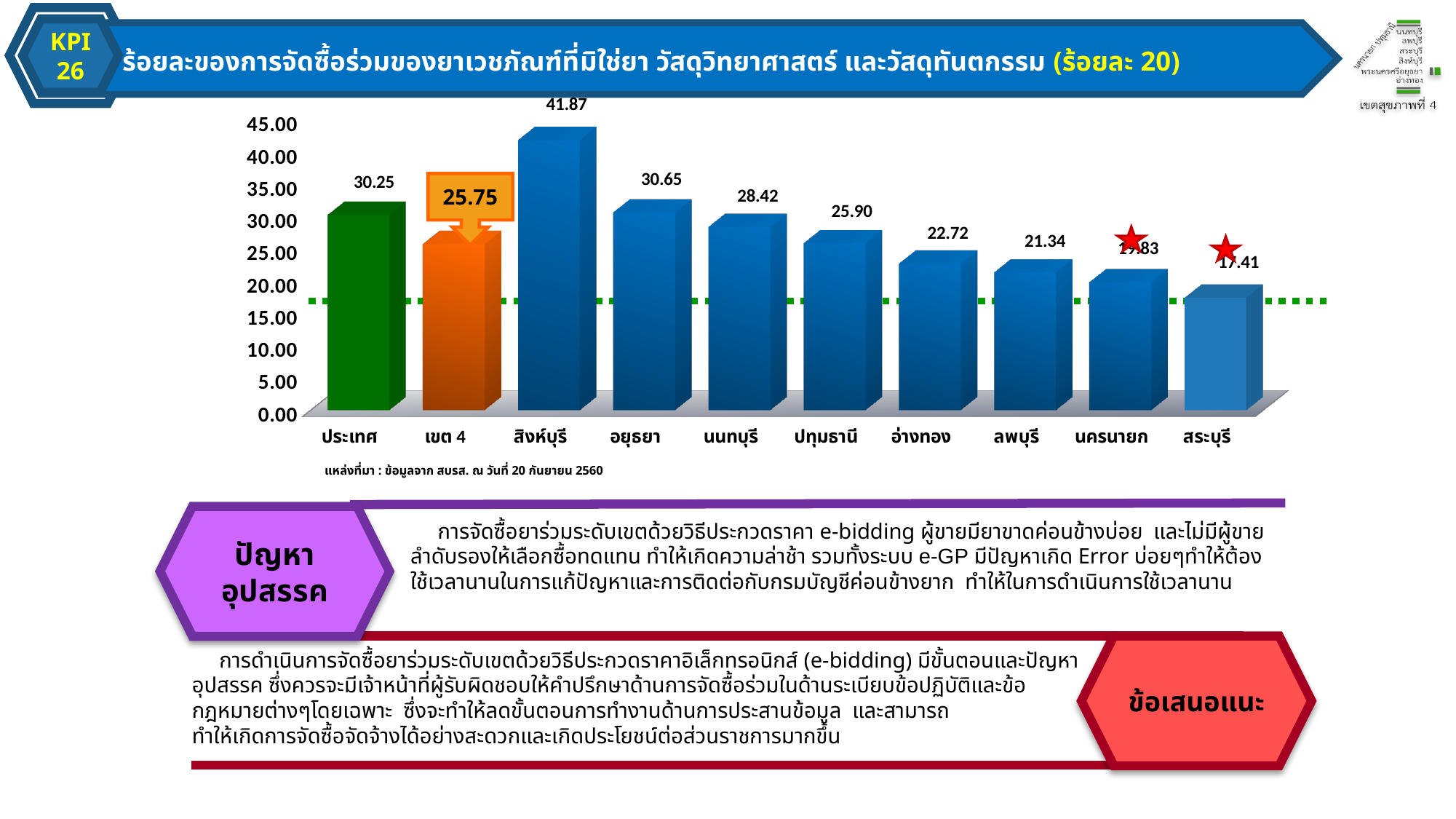
What is the value for สิงห์บุรี? 41.87 What is the value for เขต 4? 25.75 Is the value for สระบุรี greater or less than 20.00? less What is the value for ประเทศ? 30.25 Which category has the lowest value? สระบุรี Which category has the highest value? สิงห์บุรี What kind of chart is shown on the slide? bar chart What is the value for ปทุมธานี? 25.90 Do the values rise or fall moving from สิงห์บุรี to สระบุรี along the x axis? fall How many categories are plotted on the chart? 10 Which is larger, the value for อยุธยา or the value for นนทบุรี? อยุธยา What is the difference between the values for สิงห์บุรี and ประเทศ? 11.62